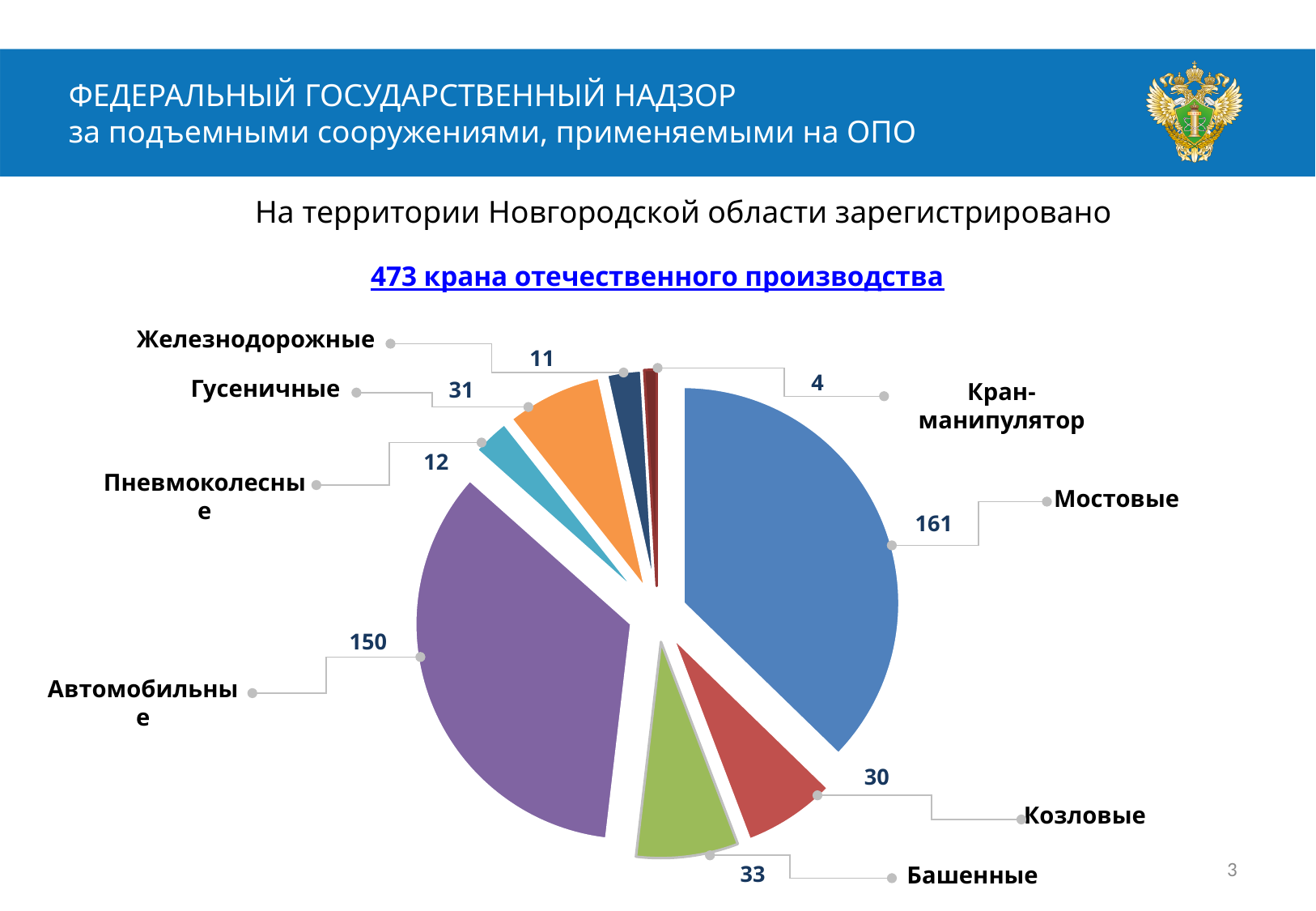
What is the difference between the values for Башенные and Козловые? 3 Which category has the smallest slice of the pie chart? Кран-манипулятор What value is shown for Кран-манипулятор on the pie chart? 4 What is the difference between the values for Мостовые and Автомобильные? 11 How many cranes of the Мостовые type are shown on the pie chart? 161 What value is shown for Автомобильные on the pie chart? 150 Which category has the largest slice of the pie chart? Мостовые Which is larger, the value for Гусеничные or the value for Пневмоколесные? Гусеничные What value is shown for Башенные on the pie chart? 33 What kind of chart is shown on the slide? Pie chart How many categories are shown on the pie chart? 8 What value is shown for Гусеничные on the pie chart? 31